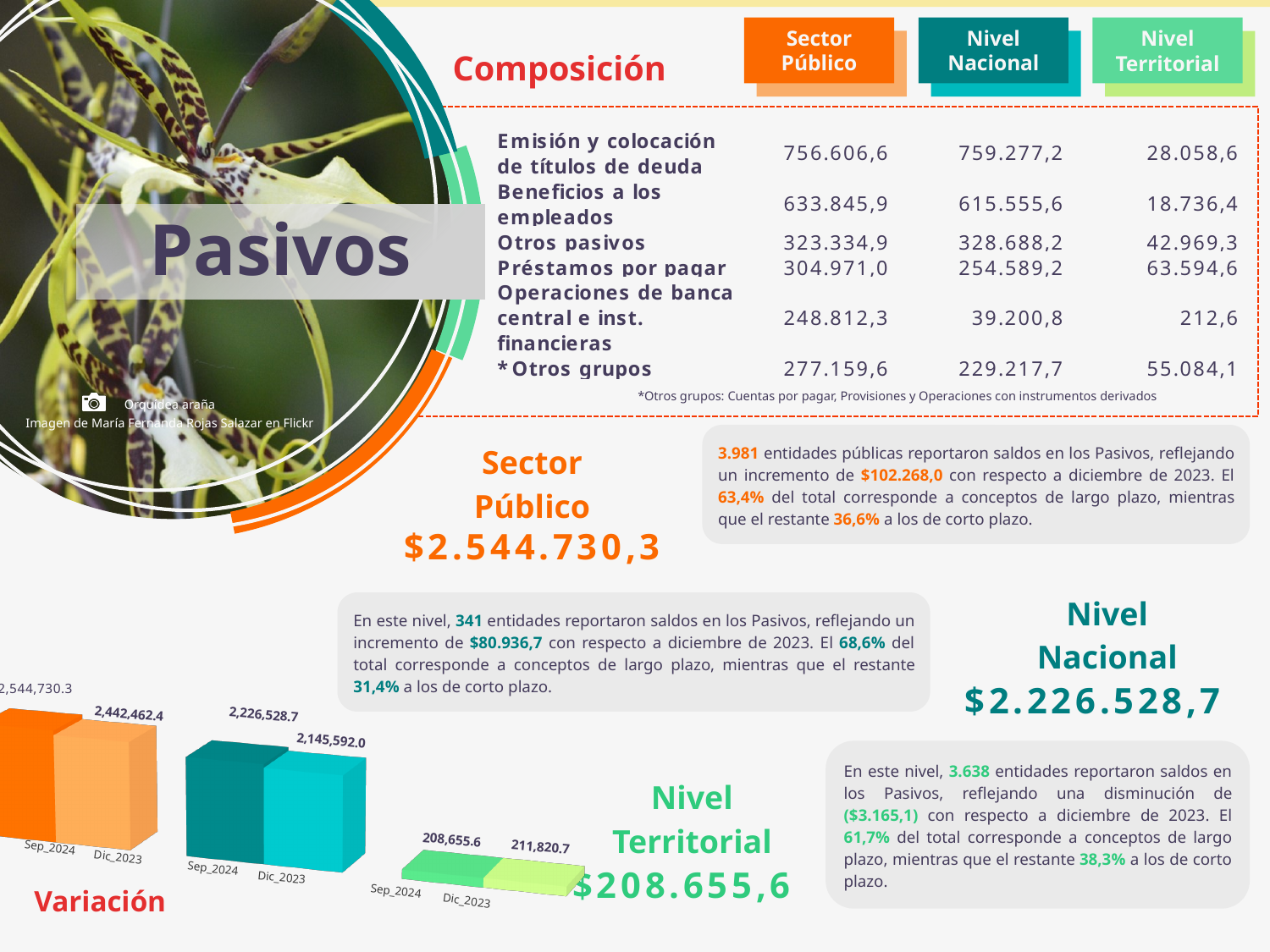
In the right (green) bar chart at the bottom of the slide, which period has the higher value, Sep_2024 or Dic_2023? Dic_2023 In the middle (teal) bar chart at the bottom of the slide, what is the value for Dic_2023? 2,145,592.0 In the middle (teal) bar chart at the bottom of the slide, which period has the lower value? Dic_2023 In the right (green) bar chart at the bottom of the slide, what is the difference between the Dic_2023 and Sep_2024 values? 3,165.1 In the left (orange) bar chart at the bottom of the slide, which period has the higher value, Sep_2024 or Dic_2023? Sep_2024 In the left (orange) bar chart at the bottom of the slide, what is the value for Dic_2023? 2,442,462.4 In the middle (teal) bar chart at the bottom of the slide, what is the value for Sep_2024? 2,226,528.7 What type of chart is used for the three small charts at the bottom of the slide? Bar chart In the middle (teal) bar chart at the bottom of the slide, what is the difference between the Sep_2024 and Dic_2023 values? 80,936.7 In the right (green) bar chart at the bottom of the slide, what is the value for Dic_2023? 211,820.7 How many bars does the right (green) chart at the bottom of the slide show? 2 In the right (green) bar chart at the bottom of the slide, what is the value for Sep_2024? 208,655.6